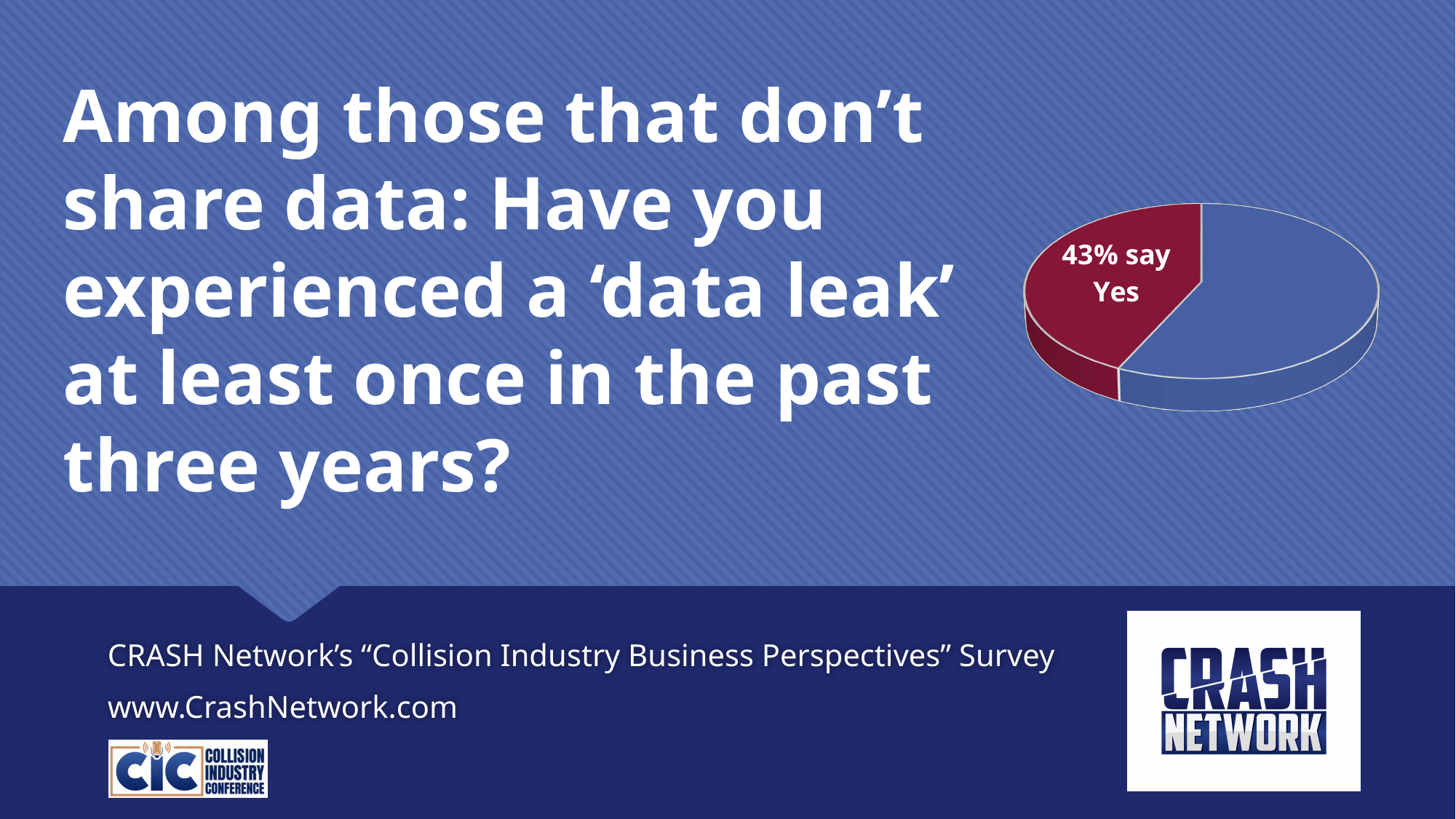
Is the 'Yes' slice of the pie chart greater or less than half of the pie? less What percentage of respondents say Yes according to the pie chart? 43% Is the 'Yes' slice greater or less than 50%? less What survey question does the pie chart on the slide answer? Among those that don't share data: Have you experienced a 'data leak' at least once in the past three years? How many slices does the pie chart have? 2 What colour is the slice labelled '43% say Yes'? red What share of the pie does the 'Yes' slice represent? 43% What kind of chart is shown on the slide? pie chart